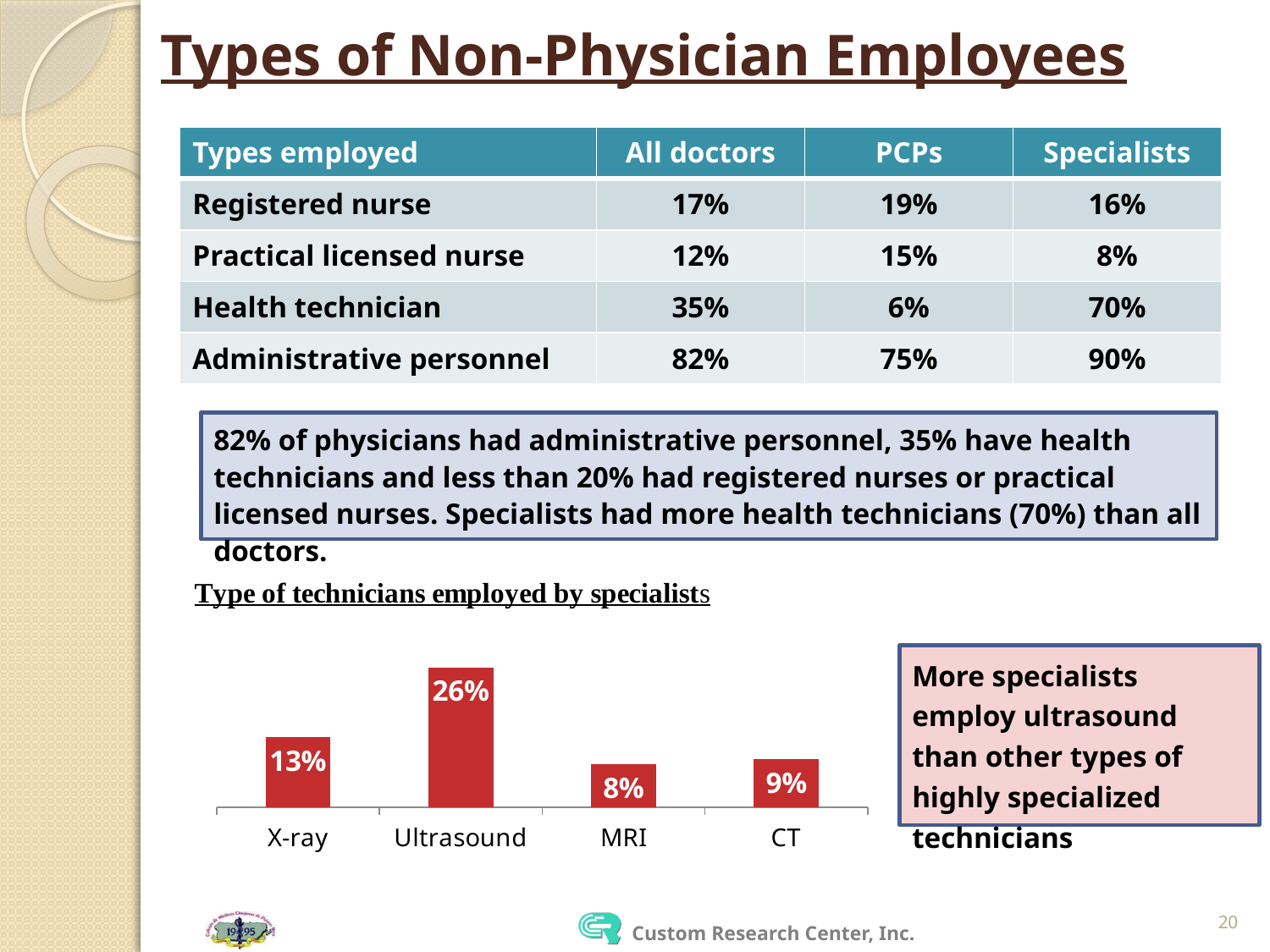
What is the value shown for X-ray in the chart? 13% What is the value shown for MRI in the chart? 8% How many types of technicians are shown in the chart? 4 What is the title of the chart on the slide? Type of technicians employed by specialists What is the difference between the Ultrasound and X-ray values in the chart? 13% What kind of chart is used to show the types of technicians employed by specialists? Bar chart What percentage of specialists employ ultrasound technicians according to the chart? 26% Which type of technician has the lowest value in the chart? MRI What is the difference between the CT and MRI values in the chart? 1% Which is larger in the chart, the value for X-ray or the value for CT? X-ray What is the value shown for CT in the chart? 9% Which type of technician has the highest value in the chart? Ultrasound